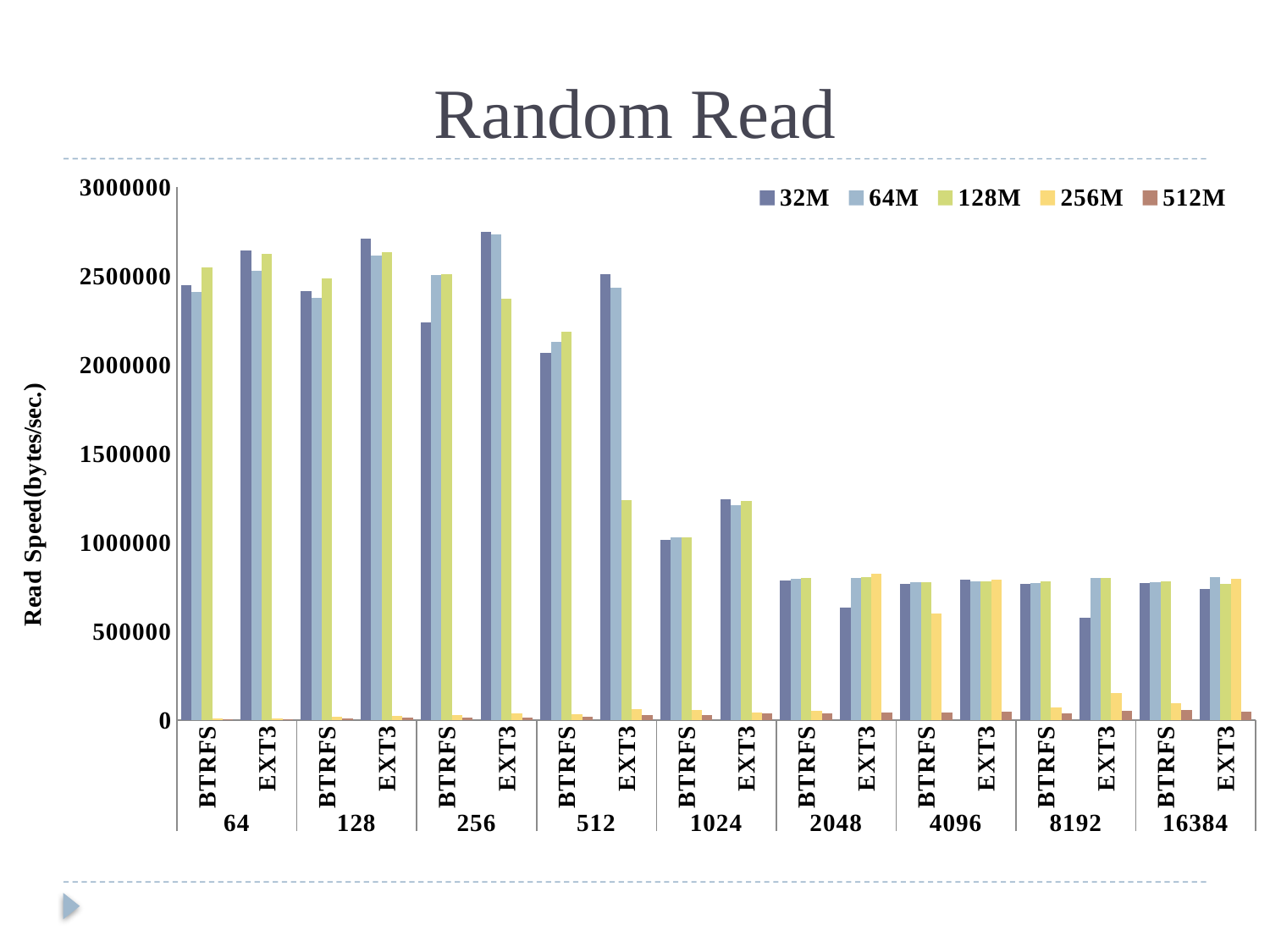
What is the title of the chart? Random Read What is the label of the y axis? Read Speed(bytes/sec.) How many block-size groups are shown along the x axis? 9 Is the 32M value for EXT3 at block size 256 greater or less than 2500000? greater How many series does the legend list? 5 Which series has the lowest values across all block sizes? 512M Do the 32M values for BTRFS generally rise or fall as block size increases from 64 to 16384? fall Is the 256M value for BTRFS at block size 2048 greater or less than 500000? less Which is larger at block size 64: the 32M value for BTRFS or the 32M value for EXT3? EXT3 Is the 32M value for BTRFS at block size 64 greater or less than 2500000? less What kind of chart is shown on the slide? bar chart